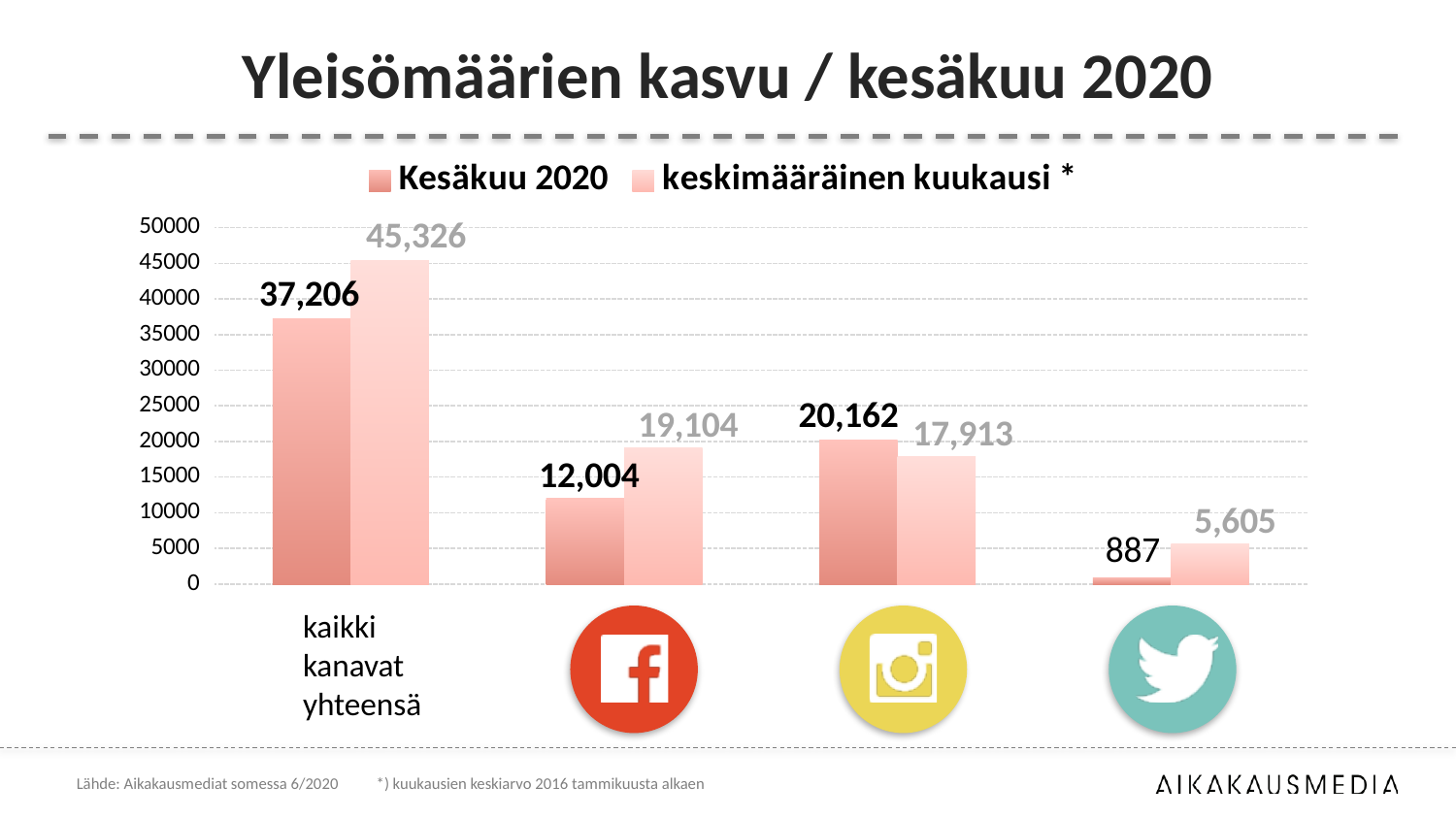
What is the difference between the keskimääräinen kuukausi value and the Kesäkuu 2020 value for kaikki kanavat yhteensä? 8,120 What is the Kesäkuu 2020 value for the Twitter category? 887 What is the keskimääräinen kuukausi value for the Instagram category? 17,913 For the Instagram category, which is larger: Kesäkuu 2020 or keskimääräinen kuukausi? Kesäkuu 2020 What is the value for Kesäkuu 2020 for kaikki kanavat yhteensä? 37,206 What is the keskimääräinen kuukausi value for the Facebook category? 19,104 Is the Kesäkuu 2020 value for the Facebook category greater or less than 15000? less Which category has the lowest Kesäkuu 2020 value? Twitter How many series does the legend list? 2 What kind of chart is shown on the slide? bar chart How many categories are shown on the x axis? 4 Which category has the highest keskimääräinen kuukausi value? kaikki kanavat yhteensä